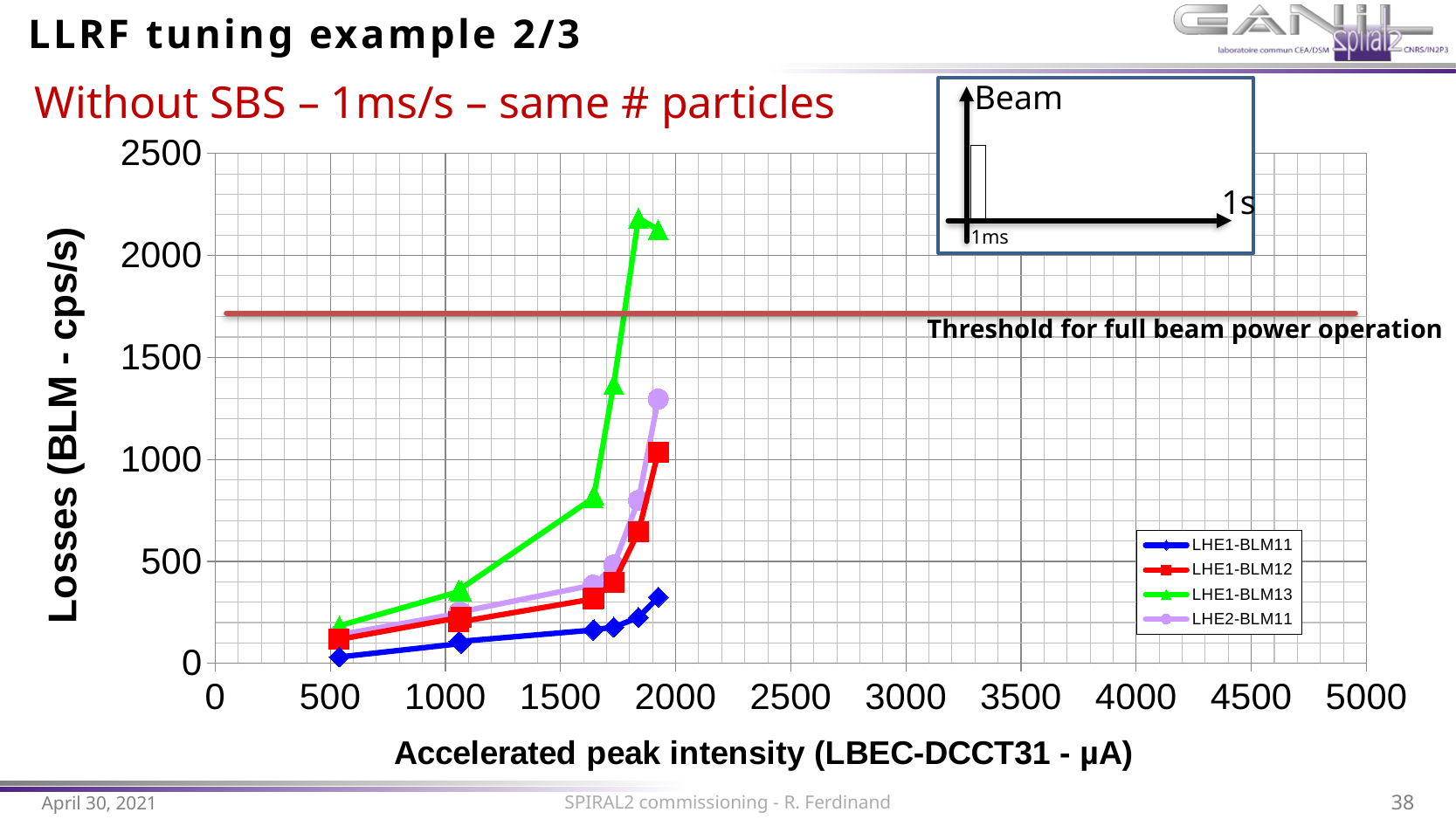
How many series does the legend list? 4 Is the highest value for LHE1-BLM11 greater or less than 500? less What does the horizontal red line on the chart represent? Threshold for full beam power operation Is the highest value for LHE2-BLM11 greater or less than 1000? greater Is the highest value for LHE2-BLM11 greater or less than 1500? less What kind of chart is shown on the slide? line chart What is the label of the y axis? Losses (BLM - cps/s) At the highest plotted intensity, which series has larger losses, LHE1-BLM13 or LHE1-BLM11? LHE1-BLM13 Which series reaches the highest losses on the chart? LHE1-BLM13 Do the losses rise or fall as the accelerated peak intensity increases? rise Which series stays lowest across the plotted intensities? LHE1-BLM11